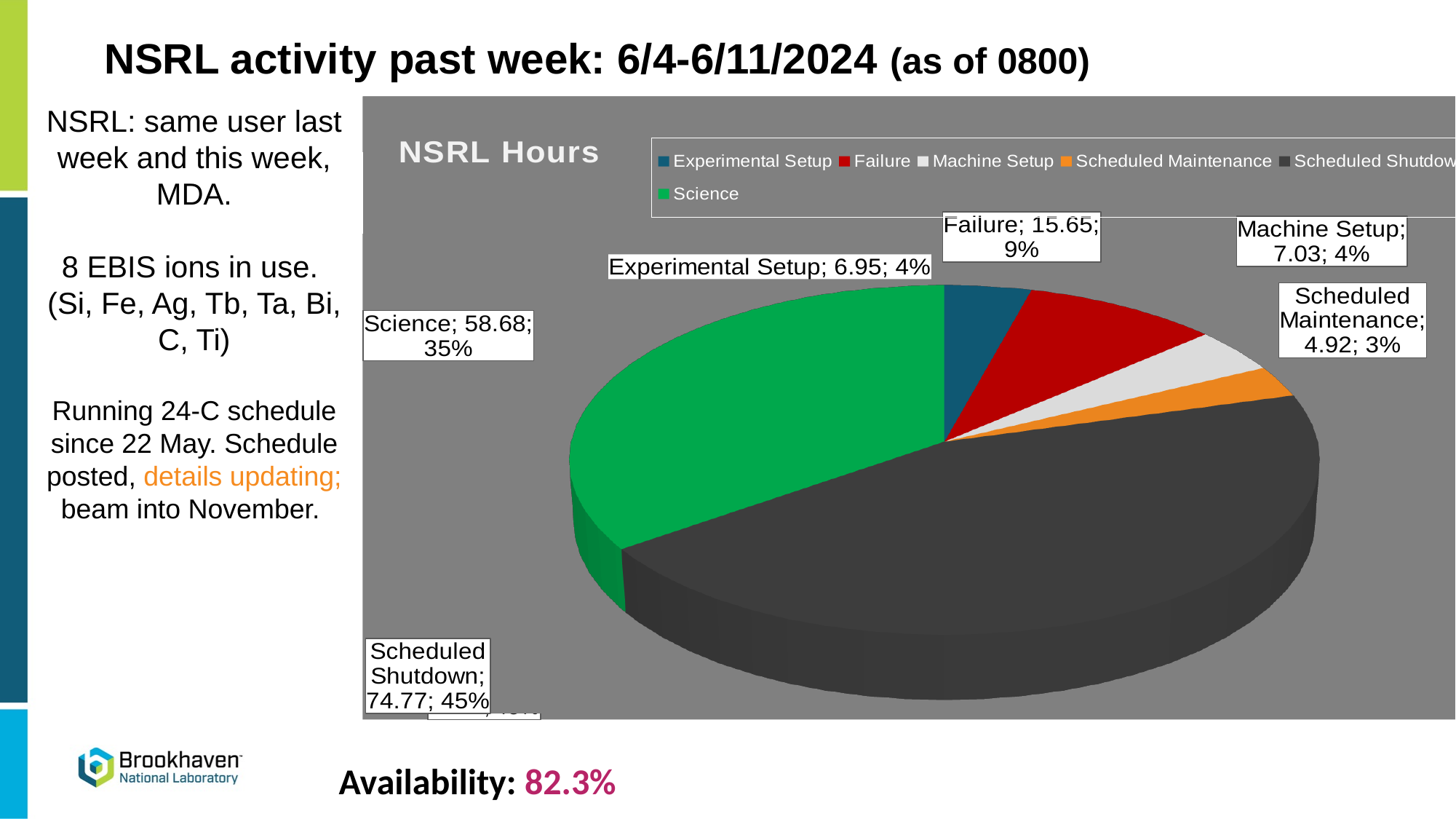
Which has more hours, Failure or Machine Setup? Failure What is the difference in hours between Scheduled Shutdown and Science? 16.09 What share of the pie does Scheduled Shutdown take? 45% What share of the pie does Machine Setup take? 4% Which category has the largest slice of the pie? Scheduled Shutdown What is the title of the chart? NSRL Hours Which category has the smallest slice of the pie? Scheduled Maintenance What kind of chart is shown on the slide? pie chart How many categories does the pie chart have? 6 How many hours are shown for Failure? 15.65 How many hours are shown for Science? 58.68 How many hours are shown for Scheduled Maintenance? 4.92